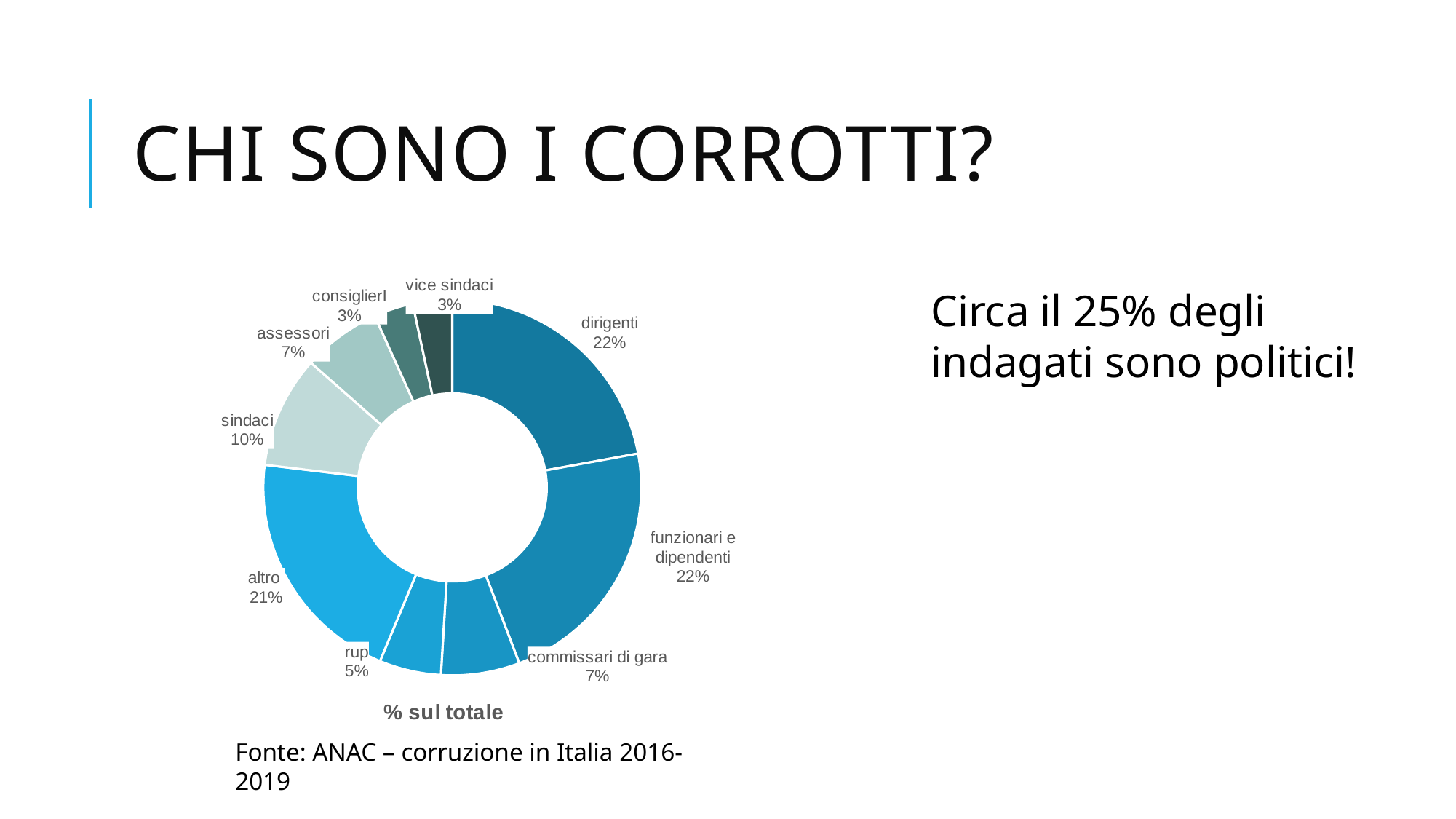
Which is larger, the share for altro or the share for sindaci? altro What is the difference between the share for dirigenti and the share for sindaci? 12% How many categories are shown in the chart? 9 What percentage of the total is shown for dirigenti? 22% What is the value for commissari di gara? 7% What percentage is shown for vice sindaci? 3% What is the value for funzionari e dipendenti? 22% What is the value shown for altro? 21% What share of the total do sindaci account for? 10% What is the title of the chart? % sul totale What kind of chart is shown on the slide? doughnut chart What percentage is shown for rup? 5%